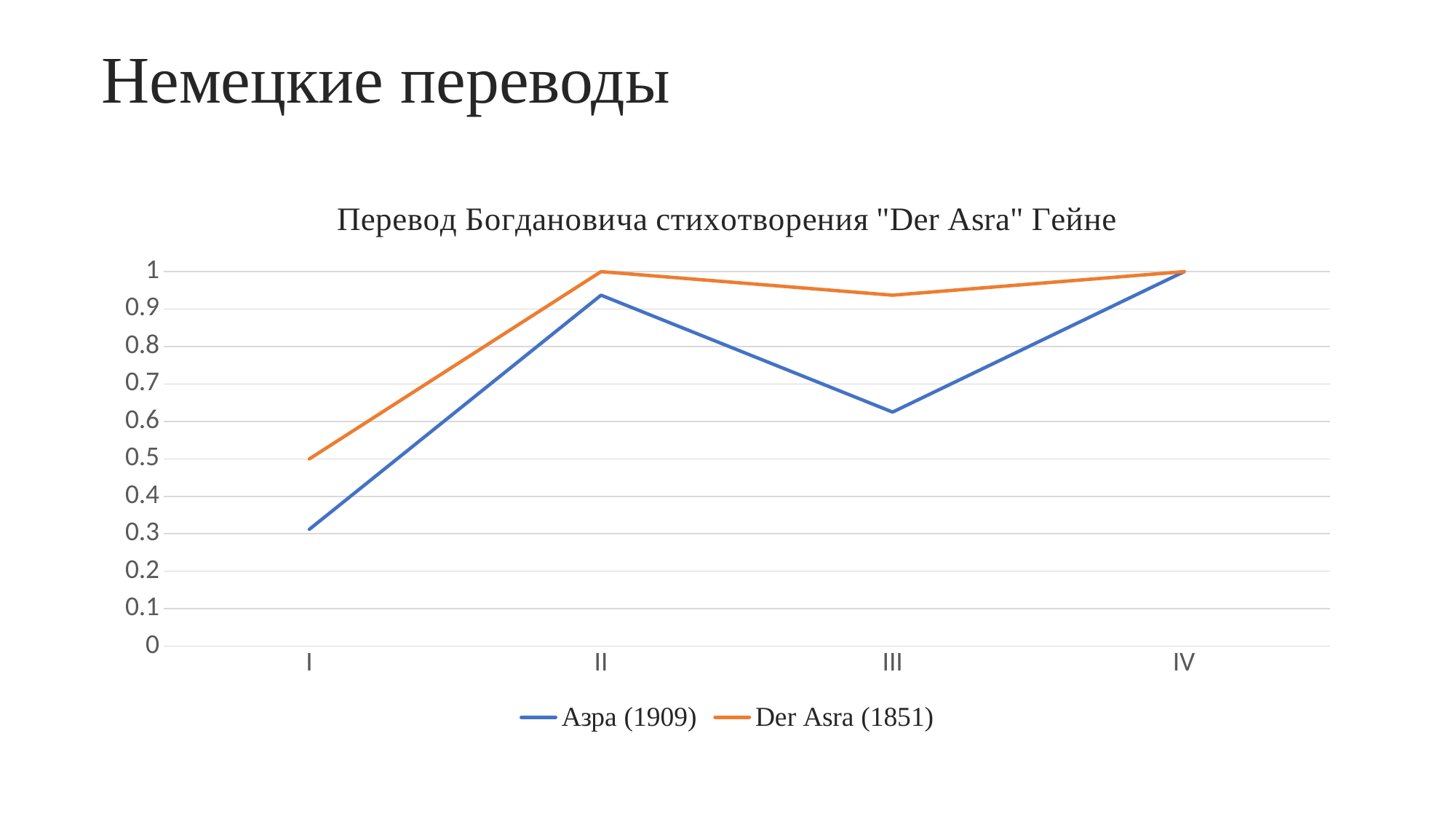
How many series does the legend list? 2 What is the value for Азра (1909) at category IV? 1 What is the value for Der Asra (1851) at category II? 1 Is the value for Азра (1909) at category III greater or less than 0.7? less How many categories are shown on the x axis? 4 What is the title of the chart? Перевод Богдановича стихотворения "Der Asra" Гейне Is the value for Азра (1909) at category I greater or less than 0.4? less Which series has the larger value at category III, Азра (1909) or Der Asra (1851)? Der Asra (1851) At which category is the value for Азра (1909) lowest? I What is the value for Der Asra (1851) at category I? 0.5 What kind of chart is shown on the slide? line chart Is the value for Der Asra (1851) at category III greater or less than 0.9? greater